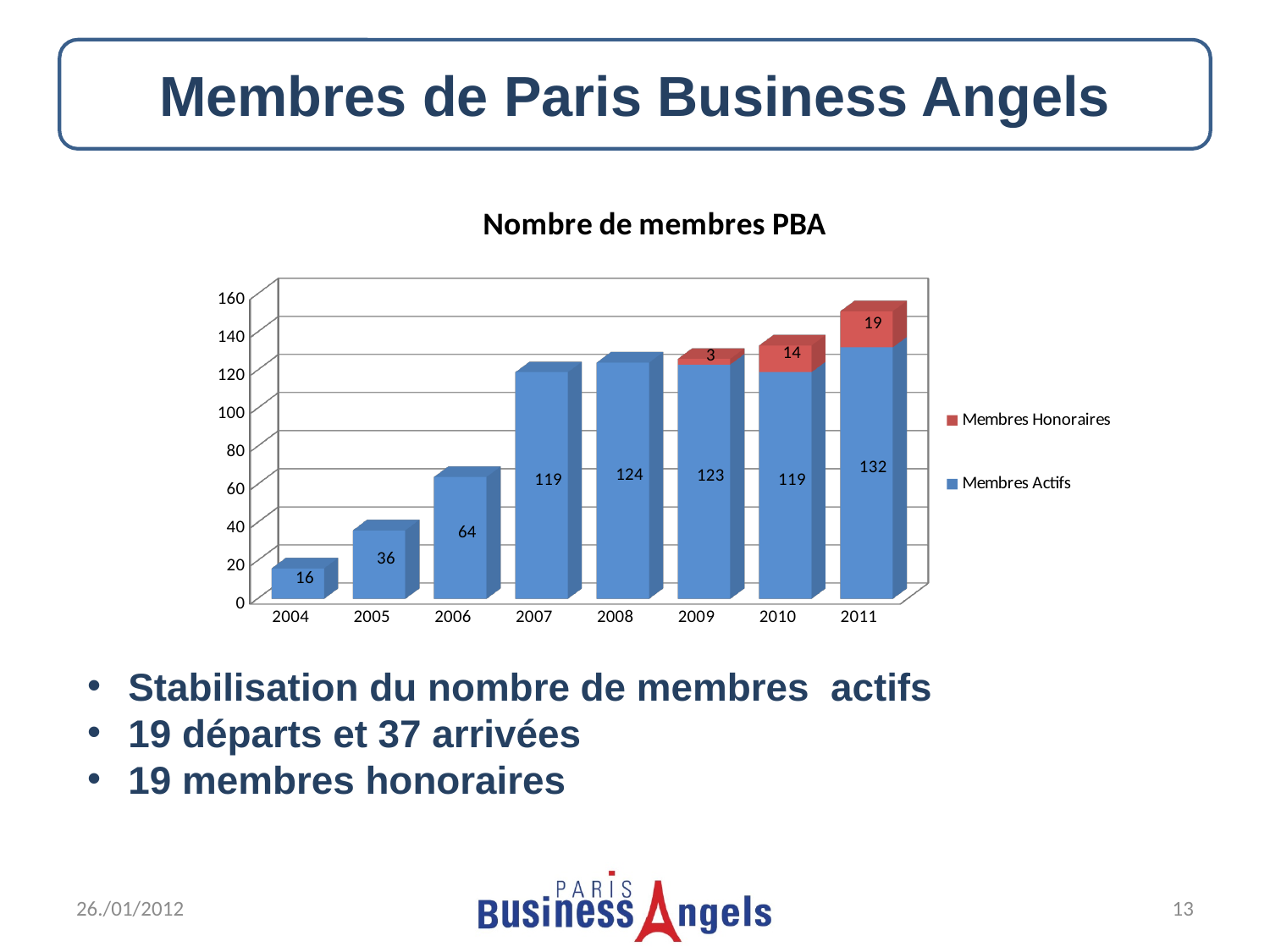
What is the total of the stacked bar for 2011? 151 What is the difference between Membres Actifs in 2008 and in 2007? 5 How many series does the legend list? 2 What is the value for Membres Honoraires in 2010? 14 Which is larger, Membres Actifs in 2006 or in 2005? 2006 What is the value for Membres Actifs in 2004? 16 How many years are shown on the x axis? 8 What is the total of the stacked bar for 2009? 126 Which year has the lowest value for Membres Actifs? 2004 Which year has the highest value for Membres Actifs? 2011 What is the value for Membres Actifs in 2011? 132 What kind of chart is shown? Stacked bar chart